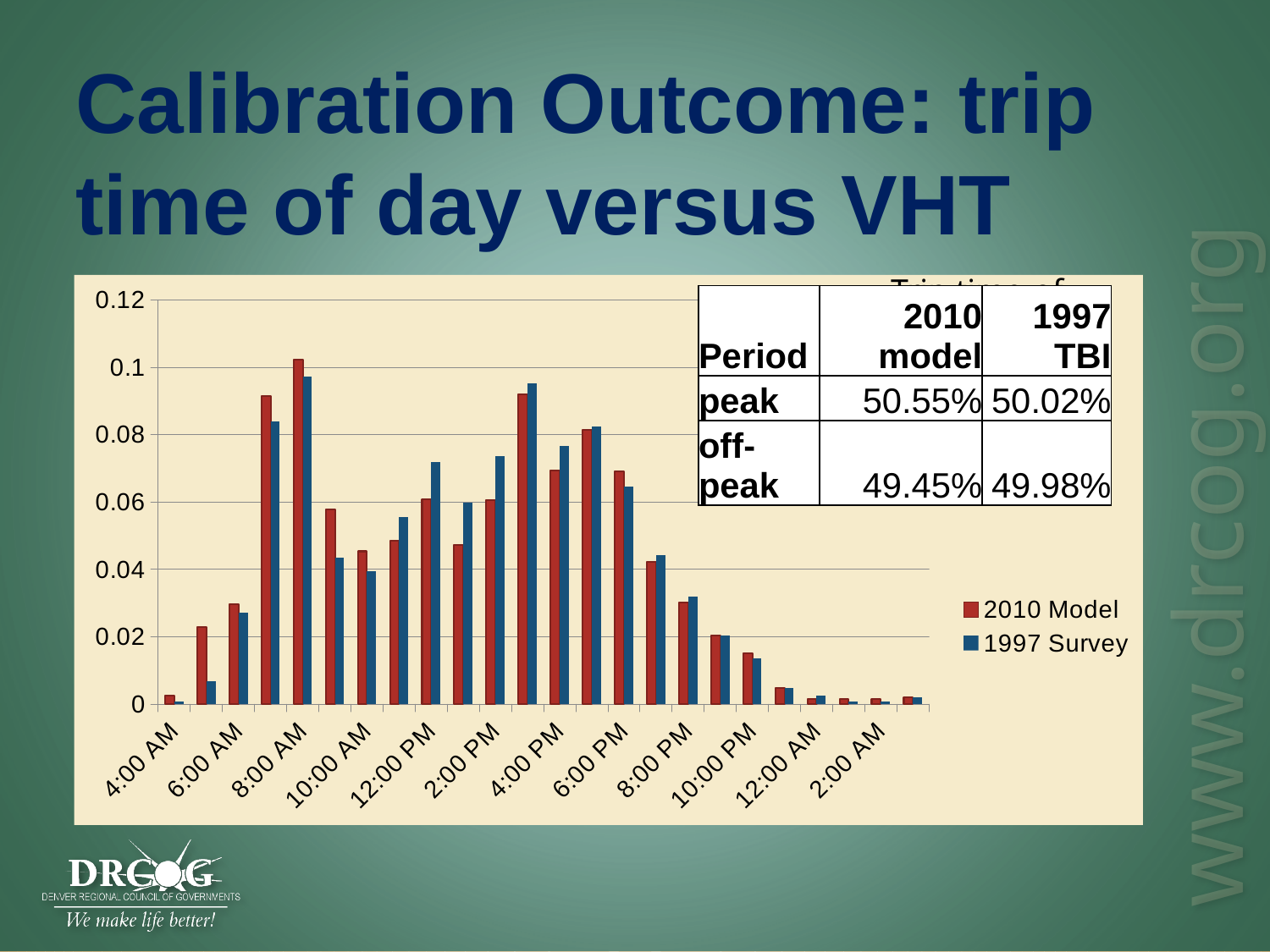
At 12:00 PM, which series has the larger value, 2010 Model or 1997 Survey? 1997 Survey Is the 2010 Model value at 4:00 PM greater or less than 0.08? less How many series does the chart legend list? 2 Is the 2010 Model value at 8:00 AM greater or less than 0.1? greater Which colour represents the 2010 Model series in the chart? red What are the two series named in the chart legend? 2010 Model and 1997 Survey Is the 1997 Survey value at 12:00 PM greater or less than 0.06? greater At which time of day does the 2010 Model series reach its highest value? 8:00 AM Do the values generally rise or fall from 8:00 PM to 2:00 AM? fall What type of chart is shown on the slide? bar chart